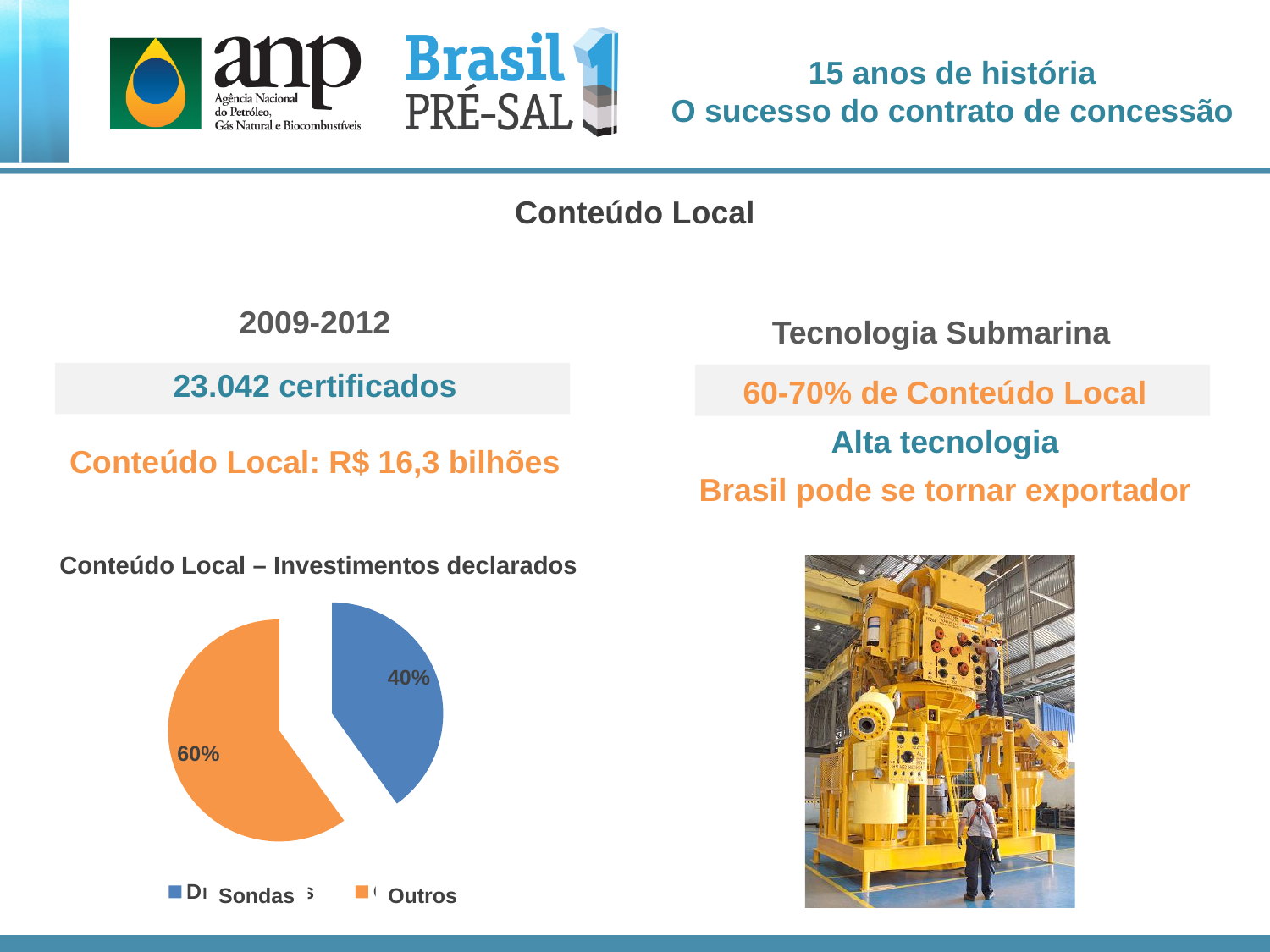
What is the difference in percentage points between the Outros slice and the Sondas slice? 20% What kind of chart is shown under the title "Conteúdo Local – Investimentos declarados"? pie chart Which is larger in the pie chart, Sondas or Outros? Outros Which slice of the pie chart is the smallest? Sondas Which slice of the pie chart is the largest? Outros How many slices does the pie chart have? 2 How many entries does the legend of the pie chart list? 2 What share of the pie chart does Sondas represent? 40% Is the share for Sondas greater or less than 50%? less What is the title of the pie chart? Conteúdo Local – Investimentos declarados What colour is the Outros slice in the pie chart? orange What share of the pie chart does Outros represent? 60%